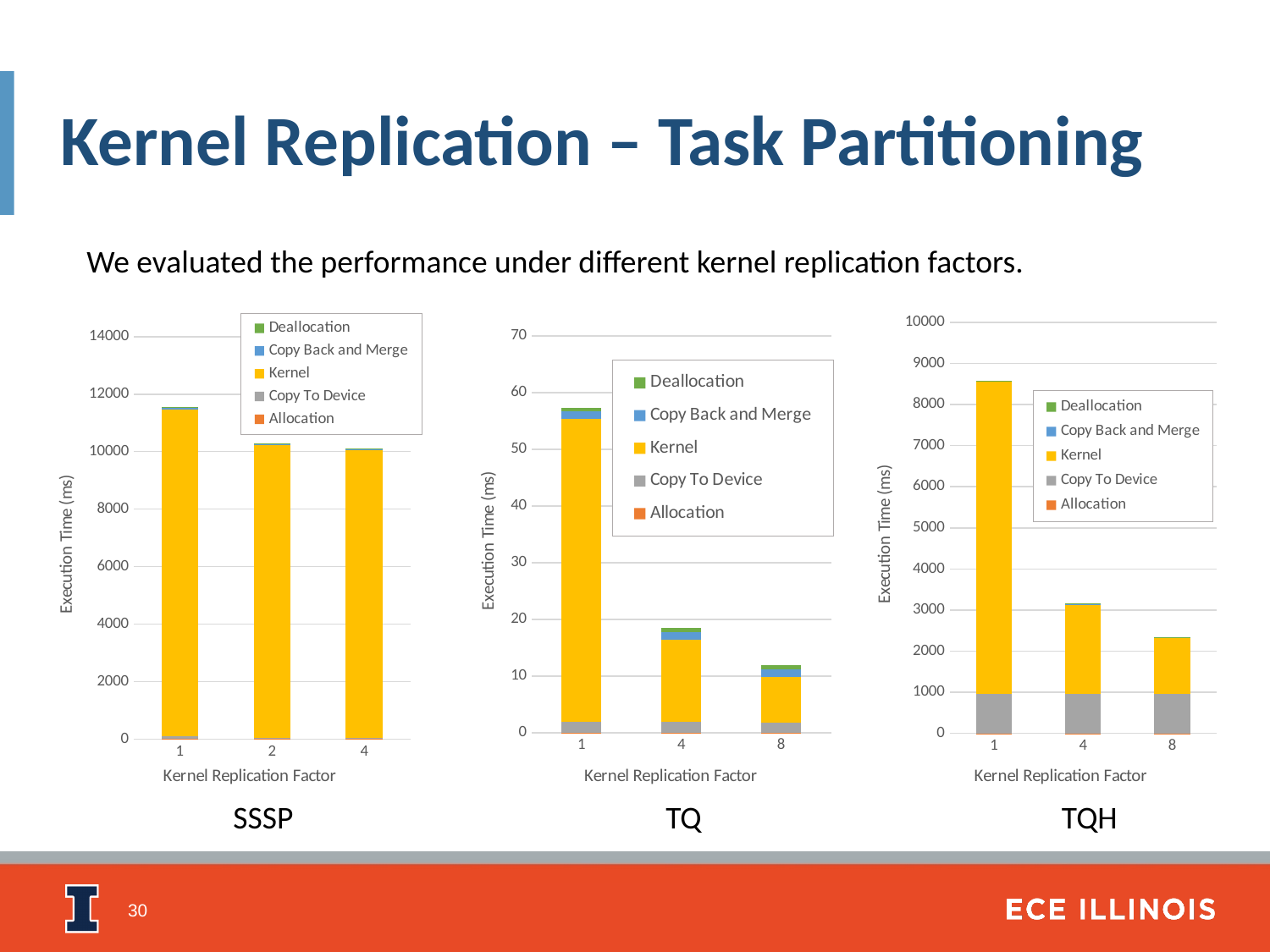
In the TQ chart, which kernel replication factor has the lowest total execution time? 8 How many kernel replication factors are plotted on the TQH chart? 3 In the TQH chart, is the total execution time for kernel replication factor 1 greater or less than 8000? greater In the TQ chart, is the total execution time for kernel replication factor 4 greater or less than 20? less In the TQH chart, which kernel replication factor has the highest total execution time? 1 In the TQH chart, which series is shown in yellow? Kernel In the TQ chart, does the total execution time rise or fall as the kernel replication factor increases? fall How many series does the legend of the TQ chart list? 5 In the TQH chart, is the total execution time for kernel replication factor 8 greater or less than 3000? less In the SSSP chart, which kernel replication factor has the highest total execution time? 1 What kind of chart is the SSSP chart? stacked bar chart